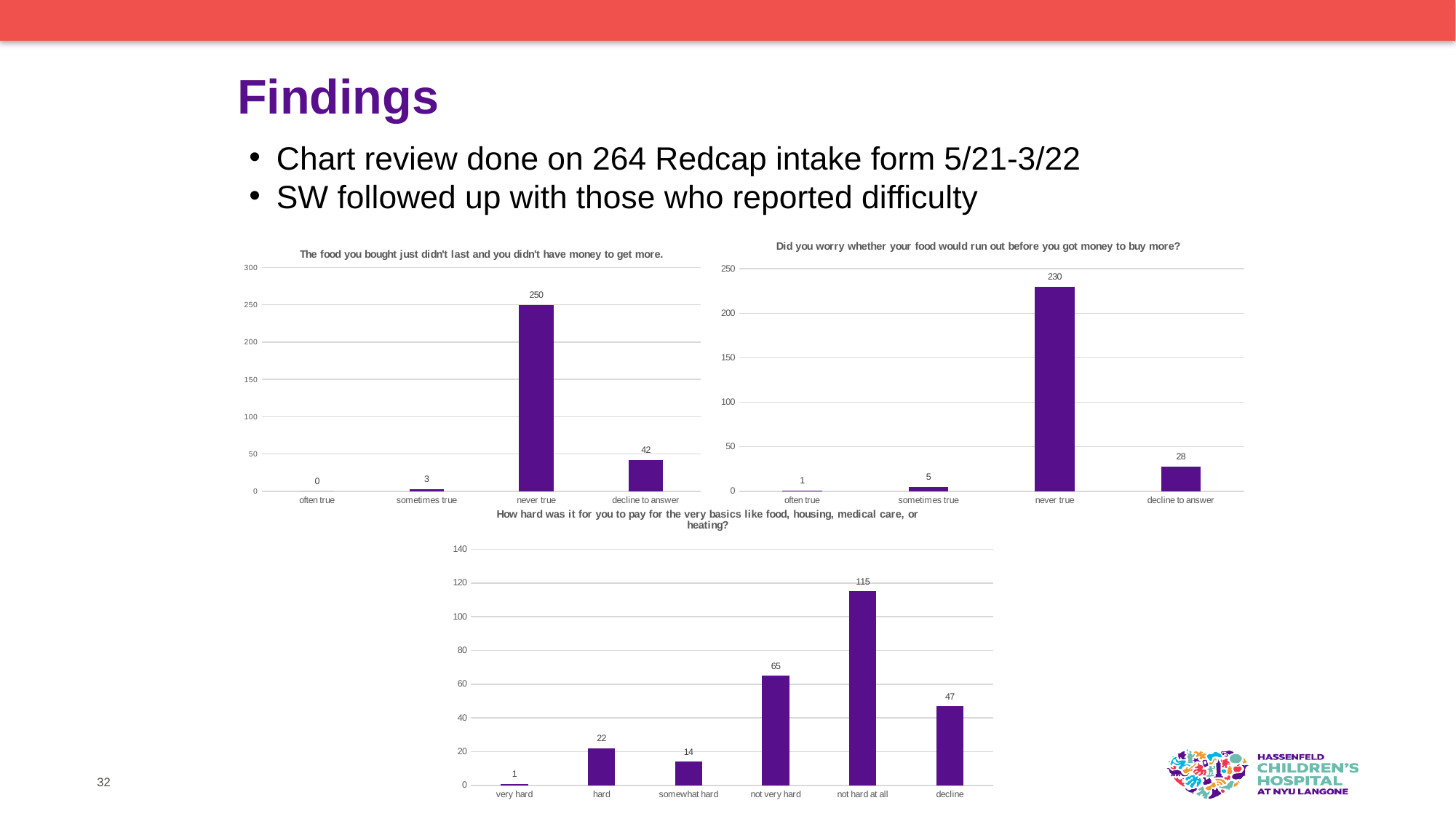
What kind of chart is the chart titled "Did you worry whether your food would run out before you got money to buy more?"? bar chart In the chart titled "The food you bought just didn't last and you didn't have money to get more.", which category has the lowest value? often true In the chart titled "How hard was it for you to pay for the very basics like food, housing, medical care, or heating?", which category has the highest value? not hard at all In the chart titled "How hard was it for you to pay for the very basics like food, housing, medical care, or heating?", which is larger, "not very hard" or "decline"? not very hard In the chart titled "Did you worry whether your food would run out before you got money to buy more?", what is the difference between "never true" and "decline to answer"? 202 In the chart titled "How hard was it for you to pay for the very basics like food, housing, medical care, or heating?", what is the difference between "hard" and "very hard"? 21 In the chart titled "How hard was it for you to pay for the very basics like food, housing, medical care, or heating?", how many categories are shown on the x axis? 6 In the chart titled "How hard was it for you to pay for the very basics like food, housing, medical care, or heating?", what is the value for "somewhat hard"? 14 In the chart titled "Did you worry whether your food would run out before you got money to buy more?", how many categories are shown on the x axis? 4 In the chart titled "The food you bought just didn't last and you didn't have money to get more.", what is the value for "decline to answer"? 42 In the chart titled "Did you worry whether your food would run out before you got money to buy more?", what is the value for "never true"? 230 In the chart titled "The food you bought just didn't last and you didn't have money to get more.", what is the value for "never true"? 250